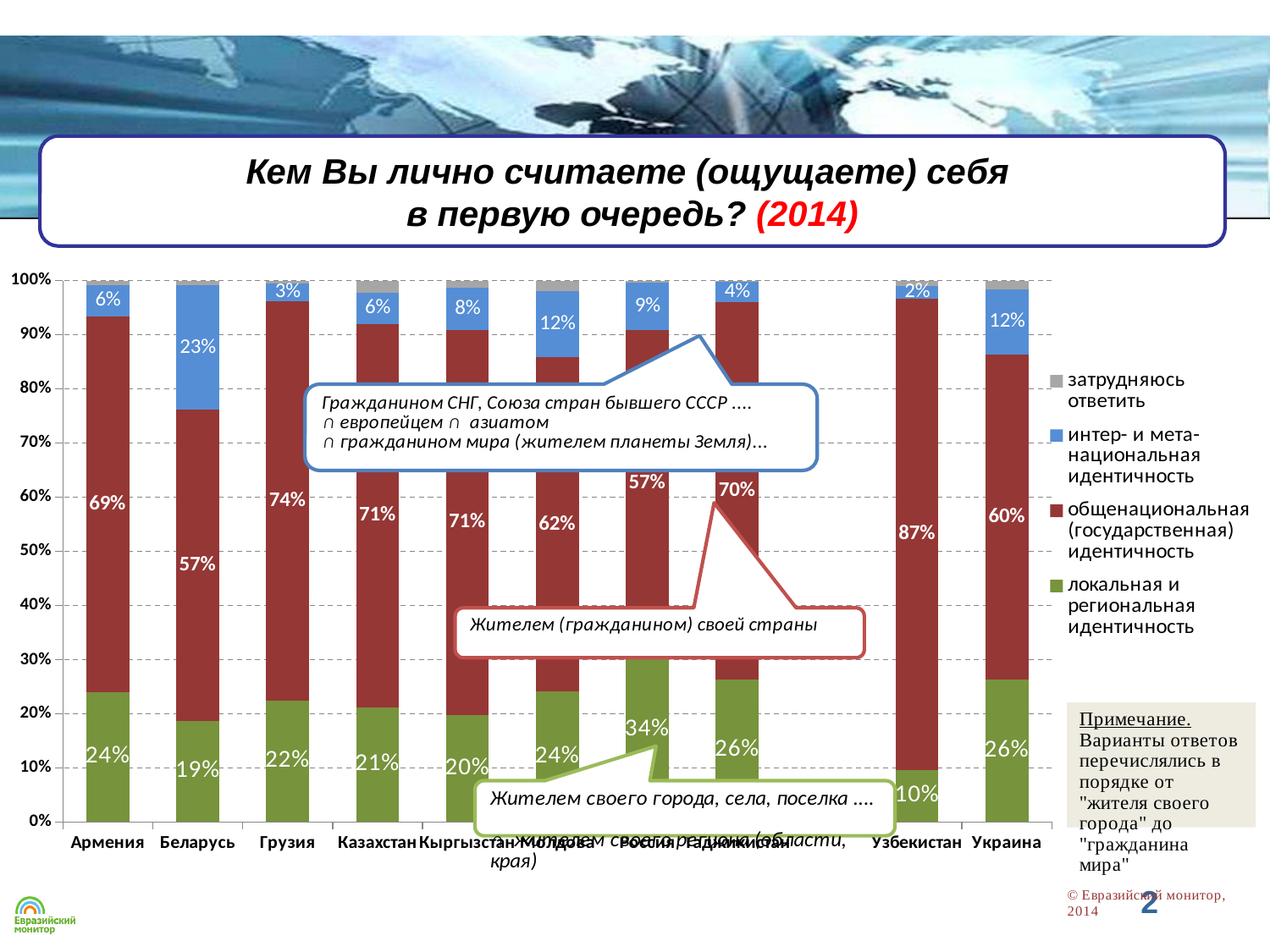
Which country has the highest value for общенациональная (государственная) идентичность? Узбекистан What kind of chart is shown on the slide? Stacked bar chart What is the value of локальная и региональная идентичность for Армения? 24% What year is given in the chart title? 2014 How many series does the chart legend list? 4 What is the difference between the общенациональная (государственная) идентичность values for Армения and Беларусь? 12 percentage points What is the value of интер- и мета-национальная идентичность for Украина? 12% How many countries are shown along the x axis of the chart? 10 Which has a larger value for общенациональная (государственная) идентичность, Грузия or Казахстан? Грузия Which country has the highest value for интер- и мета-национальная идентичность? Беларусь What is the value of общенациональная (государственная) идентичность for Узбекистан? 87% Which country has the lowest value for локальная и региональная идентичность? Узбекистан